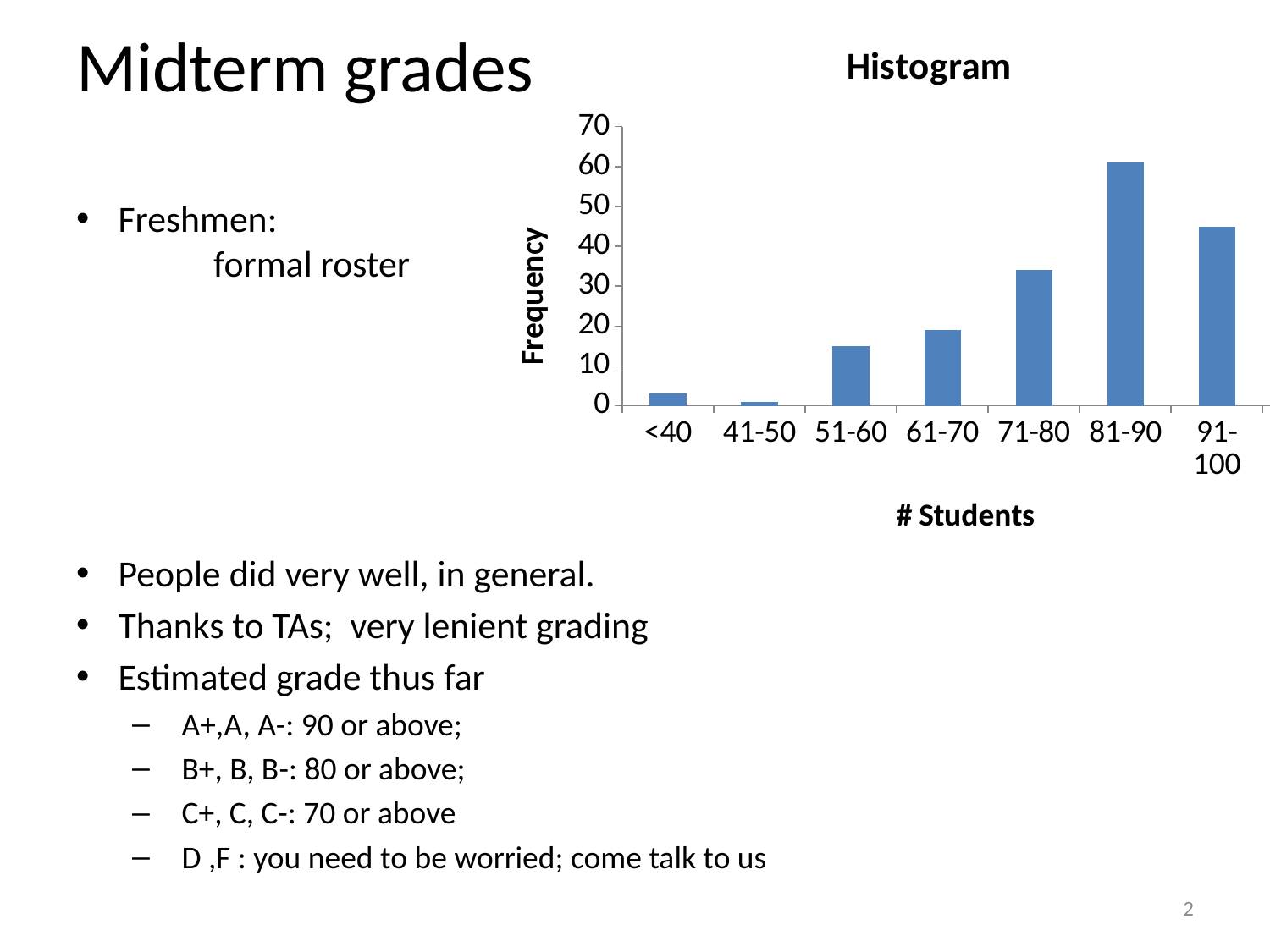
Which grade range has the lowest frequency? 41-50 Which has a higher frequency, 91-100 or 71-80? 91-100 Do the frequencies generally rise or fall from <40 to 81-90? rise Which has a higher frequency, 61-70 or 51-60? 61-70 What is the title of the chart? Histogram Is the frequency for 51-60 greater or less than 20? less Is the frequency for 81-90 greater or less than 50? greater How many grade-range categories are shown on the x axis of the chart? 7 Which grade range has the highest frequency? 81-90 Is the frequency for 91-100 greater or less than 40? greater What kind of chart is shown on the slide? bar chart What is the label on the vertical axis of the chart? Frequency